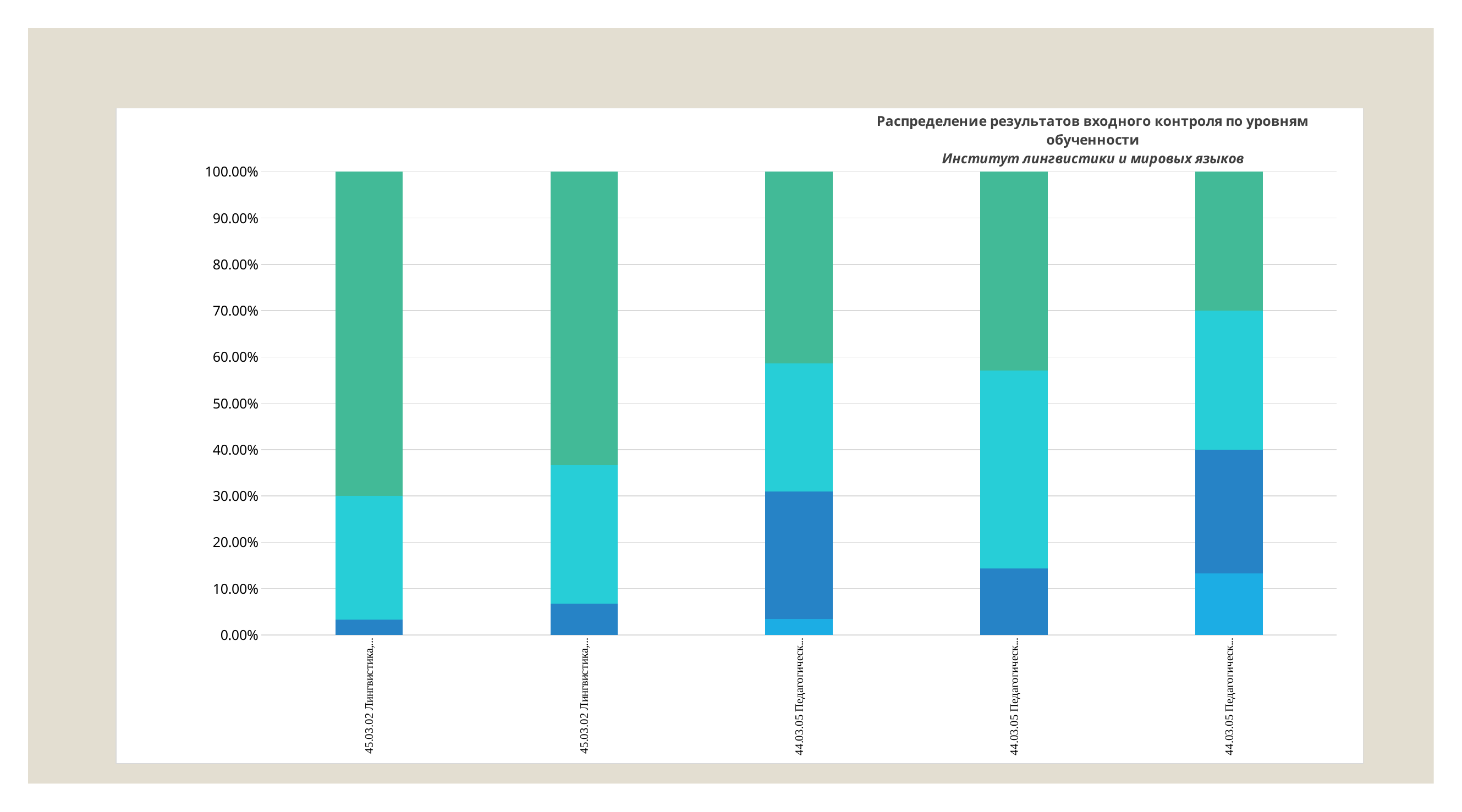
In the fifth bar from the left, is the green (top) segment greater or less than 40%? less What kind of chart is shown on the slide? Stacked bar chart Which bar has the largest green (top) segment: the first bar from the left or the fifth bar from the left? The first bar from the left In the first bar from the left, is the dark blue (bottom) segment greater or less than 10%? less In the fifth bar from the left, is the cyan (middle) segment greater or less than 20%? greater What is the title of the chart? Распределение результатов входного контроля по уровням обученности Which bar has the smallest green (top) segment overall? The fifth bar from the left (44.03.05 Педагогическ...) What is the total height of each stacked bar, as read from the y axis? 100.00% Which institute is named in the chart's subtitle? Институт лингвистики и мировых языков Which bar has the largest green (top) segment overall? The first bar from the left (45.03.02 Лингвистика) How many bars (categories) are plotted in the chart? 5